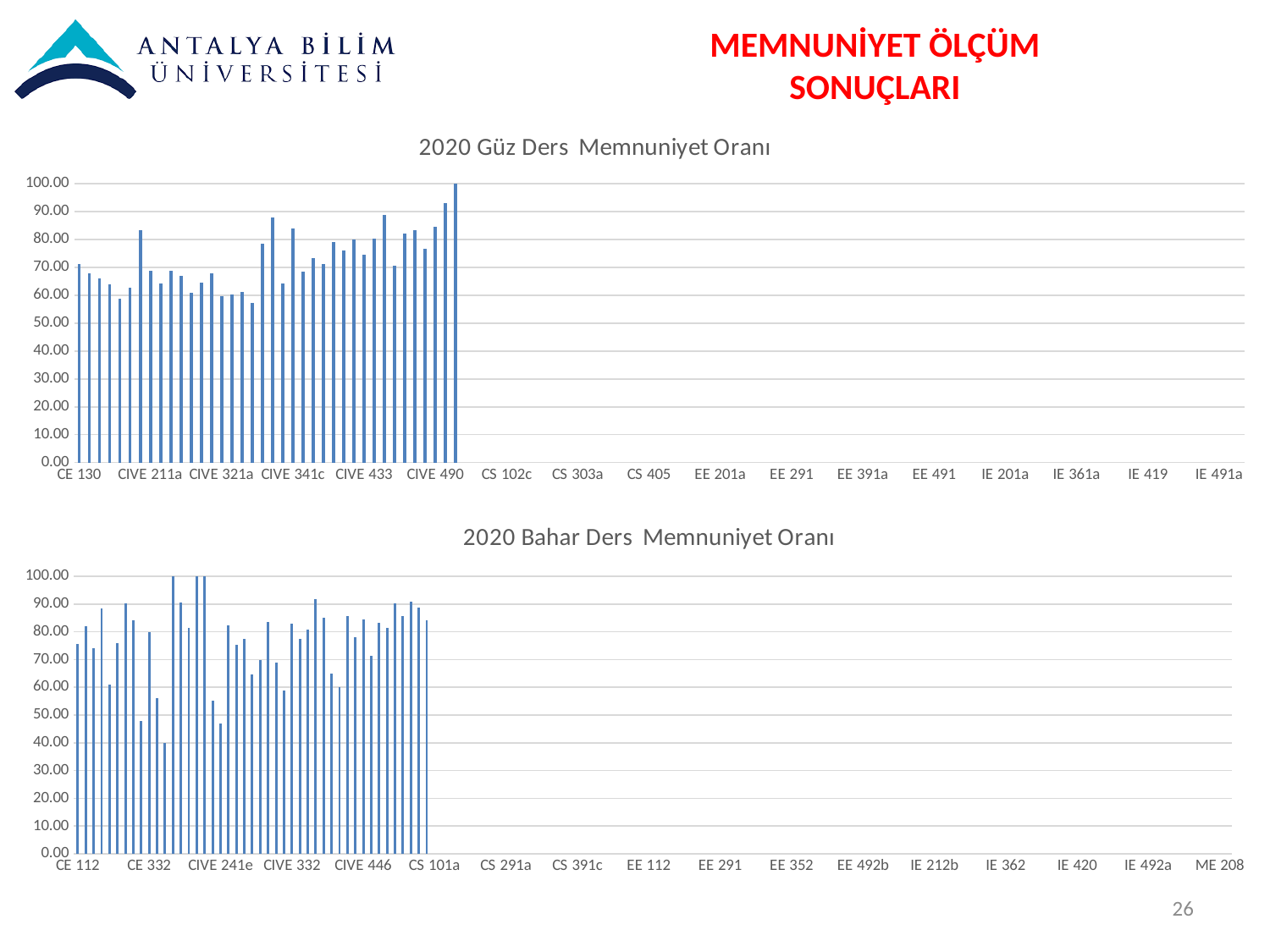
How many charts are shown on the slide? 2 In the top chart '2020 Güz Ders Memnuniyet Oranı', is the value for CE 130 greater or less than 60.00? greater What is the title of the bottom chart on the slide? 2020 Bahar Ders Memnuniyet Oranı What is the title of the top chart on the slide? 2020 Güz Ders Memnuniyet Oranı In the bottom chart '2020 Bahar Ders Memnuniyet Oranı', what is the highest value reached by any bar? 100.00 In the top chart '2020 Güz Ders Memnuniyet Oranı', what is the highest value reached by any bar? 100.00 What kind of chart is the bottom chart, '2020 Bahar Ders Memnuniyet Oranı'? bar chart In the bottom chart '2020 Bahar Ders Memnuniyet Oranı', is the value for CE 112 greater or less than 60.00? greater In the bottom chart '2020 Bahar Ders Memnuniyet Oranı', is the value for CE 112 greater or less than 90.00? less What kind of chart is the top chart, '2020 Güz Ders Memnuniyet Oranı'? bar chart What is the maximum value shown on the y axis of the top chart '2020 Güz Ders Memnuniyet Oranı'? 100.00